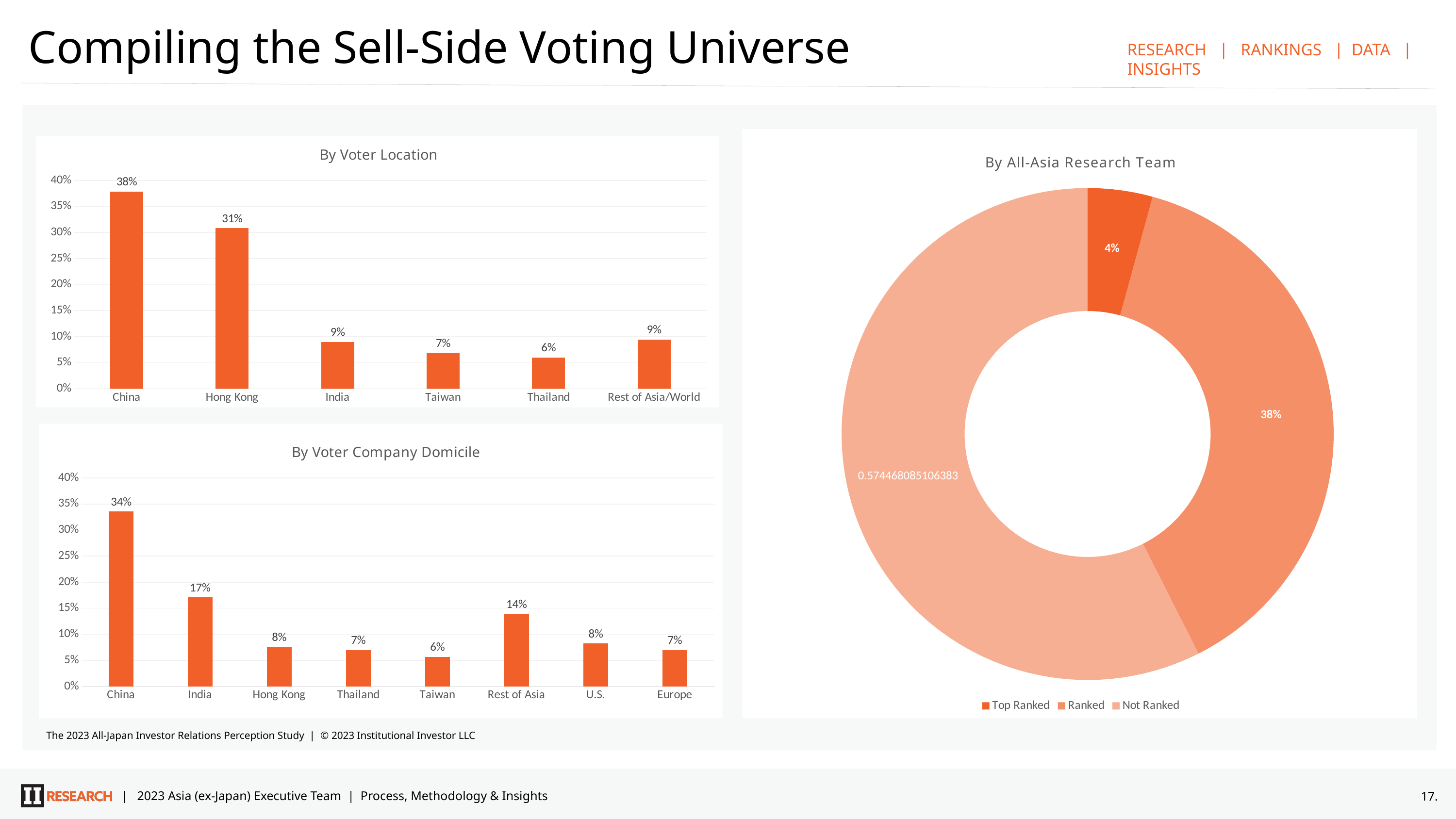
In the 'By Voter Company Domicile' chart, how many categories are shown on the x axis? 8 In the 'By All-Asia Research Team' chart, what is the value for Top Ranked? 4% In the 'By Voter Location' chart, which category has the lowest value? Thailand In the 'By Voter Location' chart, which category has the highest value? China In the 'By Voter Location' chart, what is the difference between the values for China and Hong Kong? 7% In the 'By Voter Company Domicile' chart, which is larger, the value for India or the value for U.S.? India What kind of chart is 'By Voter Company Domicile'? Bar chart In the 'By Voter Location' chart, how many categories are shown on the x axis? 6 In the 'By Voter Location' chart, what is the value for Hong Kong? 31% In the 'By Voter Company Domicile' chart, what is the value for Rest of Asia? 14% How many series does the legend of the 'By All-Asia Research Team' chart list? 3 In the 'By Voter Company Domicile' chart, which category has the highest value? China